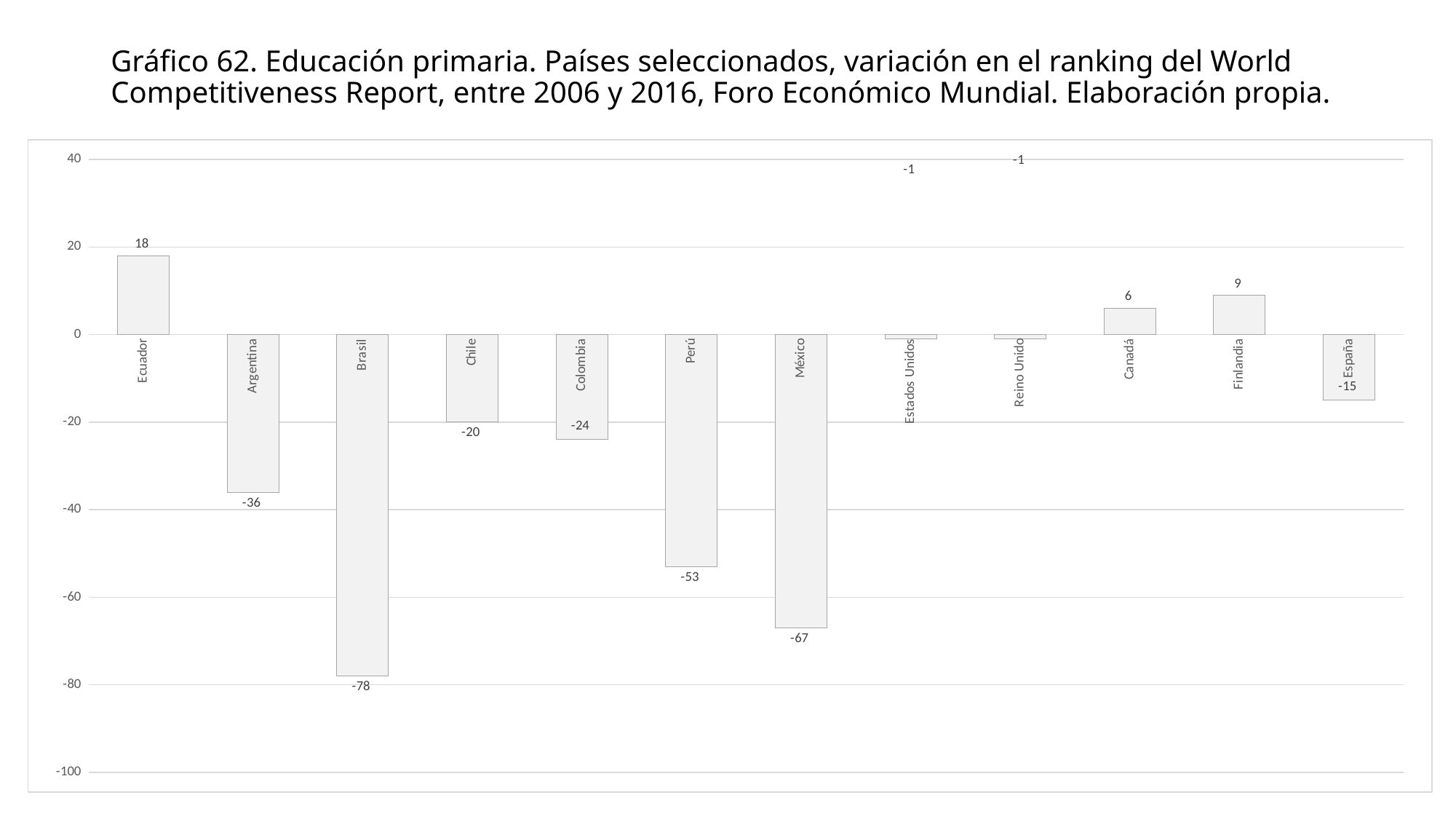
Which country has the lowest value? Brasil What is the value for México? -67 Which has a larger value, Finlandia or Canadá? Finlandia What is the value for España? -15 What is the difference between the values for Perú and Chile? 33 What is the value for Ecuador? 18 What kind of chart is this? Bar chart What is the difference between the values for Argentina and Colombia? 12 What is the value for Estados Unidos? -1 How many countries are shown in the chart? 12 Which country has the highest value? Ecuador What is the value for Brasil? -78